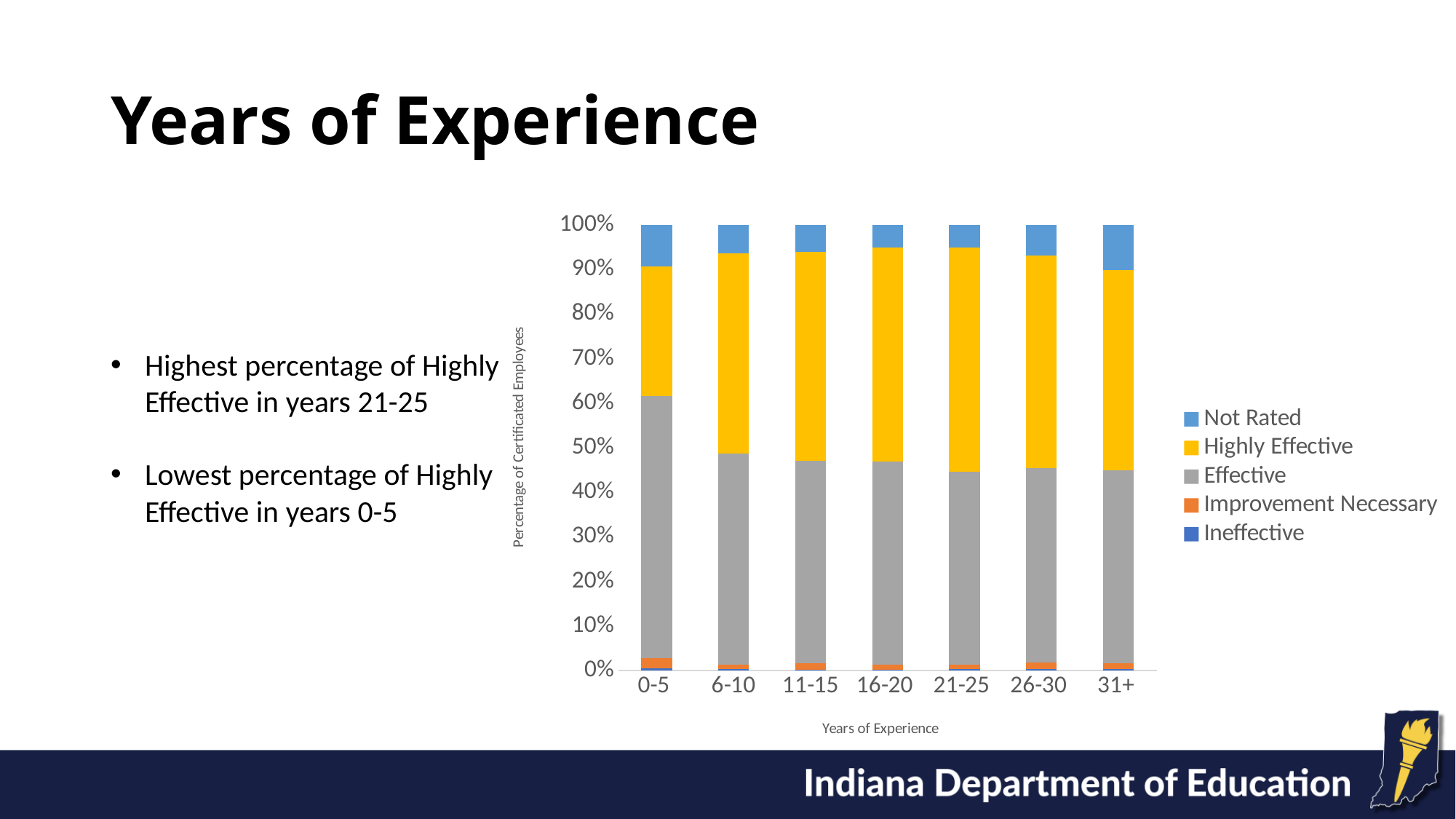
What is the label of the vertical axis? Percentage of Certificated Employees Which years-of-experience group has the lowest share of Highly Effective ratings? 0-5 Which group has a larger Highly Effective share, 0-5 or 21-25? 21-25 Which group has a larger Effective share, 0-5 or 6-10? 0-5 How many series does the legend list? 5 What kind of chart is shown on the slide? Stacked bar chart Which years-of-experience group has the highest share of Effective ratings? 0-5 How many years-of-experience categories are shown on the x axis? 7 Is the Effective share for the 0-5 group greater or less than 50%? greater Is the Effective share for the 21-25 group greater or less than 50%? less Which years-of-experience group has the highest share of Highly Effective ratings? 21-25 Does the Effective share rise or fall from the 0-5 group to the 6-10 group? fall